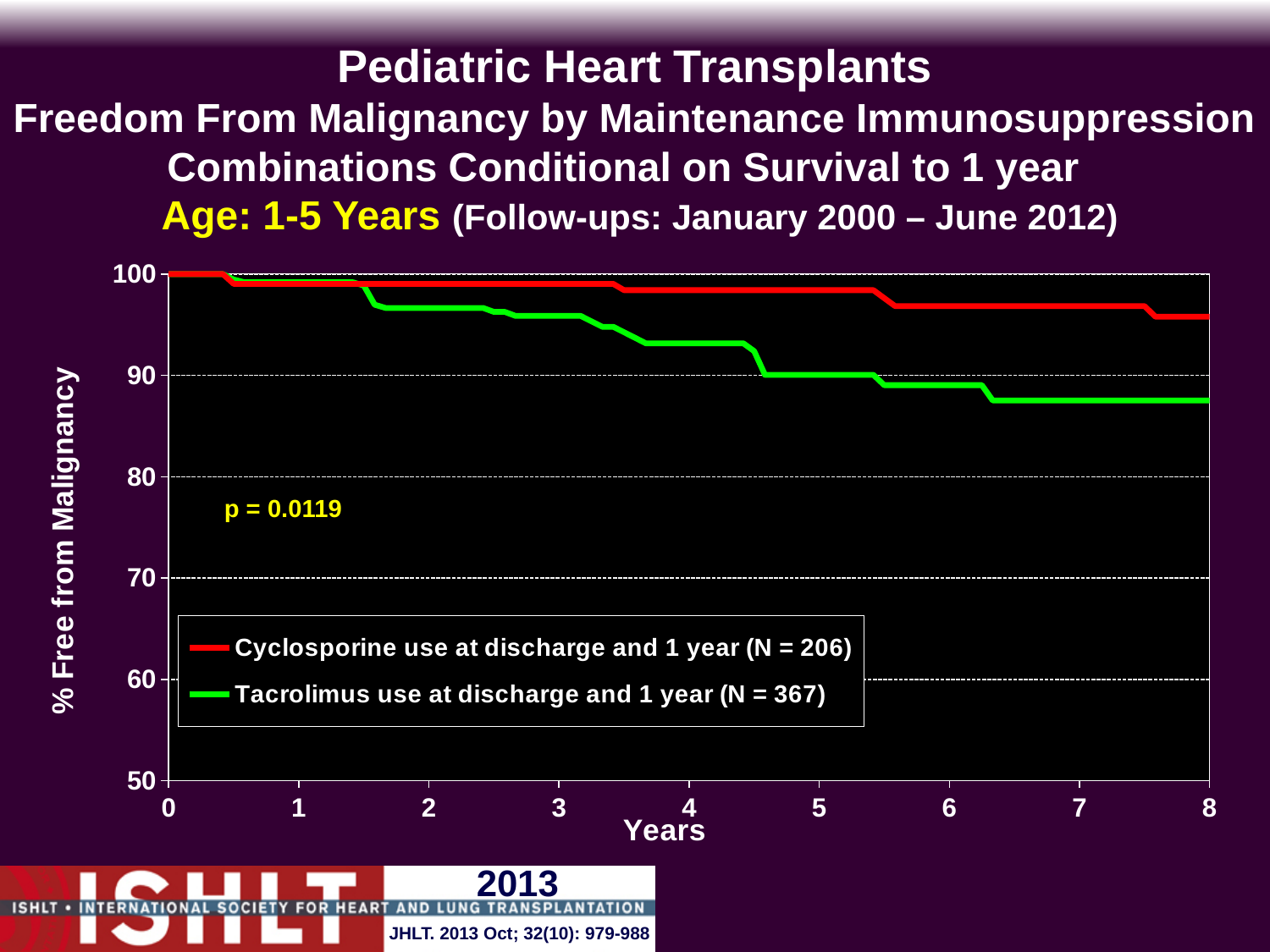
Is the value for Cyclosporine use at discharge and 1 year at 4 years greater or less than 90? greater What is the N for the Cyclosporine use at discharge and 1 year series shown in the legend? N = 206 What p-value is printed on the chart? p = 0.0119 What kind of chart is shown on the slide? line chart Is the value for Tacrolimus use at discharge and 1 year at 7 years greater or less than 90? less At 8 years, which series has the higher % free from malignancy, Cyclosporine or Tacrolimus? Cyclosporine use at discharge and 1 year How many series does the legend list? 2 Is the value for Cyclosporine use at discharge and 1 year at 8 years greater or less than 90? greater Do the values for Tacrolimus use at discharge and 1 year rise or fall as years increase? fall At 6 years, which series is higher, Cyclosporine or Tacrolimus? Cyclosporine use at discharge and 1 year